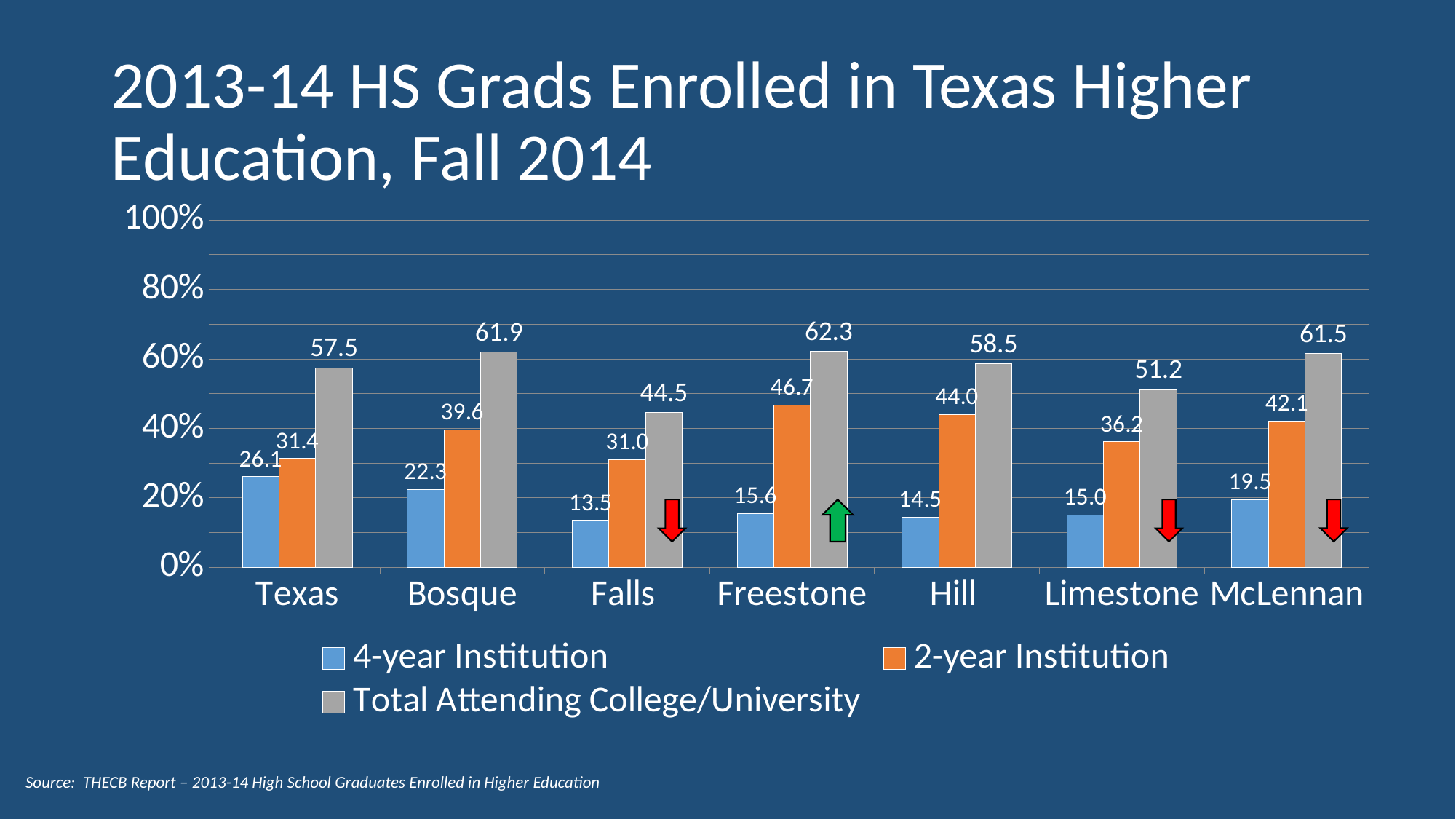
What is the 2-year Institution value for McLennan? 42.1 What is the value for 4-year Institution for Texas? 26.1 Which category has the lowest 4-year Institution value? Falls What is the difference between the Total Attending College/University values for Bosque and Falls? 17.4 What is the Total Attending College/University value for Freestone? 62.3 Which is larger, the 2-year Institution value for Hill or for Limestone? Hill How many categories are shown on the x axis? 7 Which category has the lowest Total Attending College/University value? Falls What is the difference between the 2-year Institution and 4-year Institution values for Freestone? 31.1 What kind of chart is shown on the slide? Bar chart Which category has the highest Total Attending College/University value? Freestone How many series does the legend list? 3